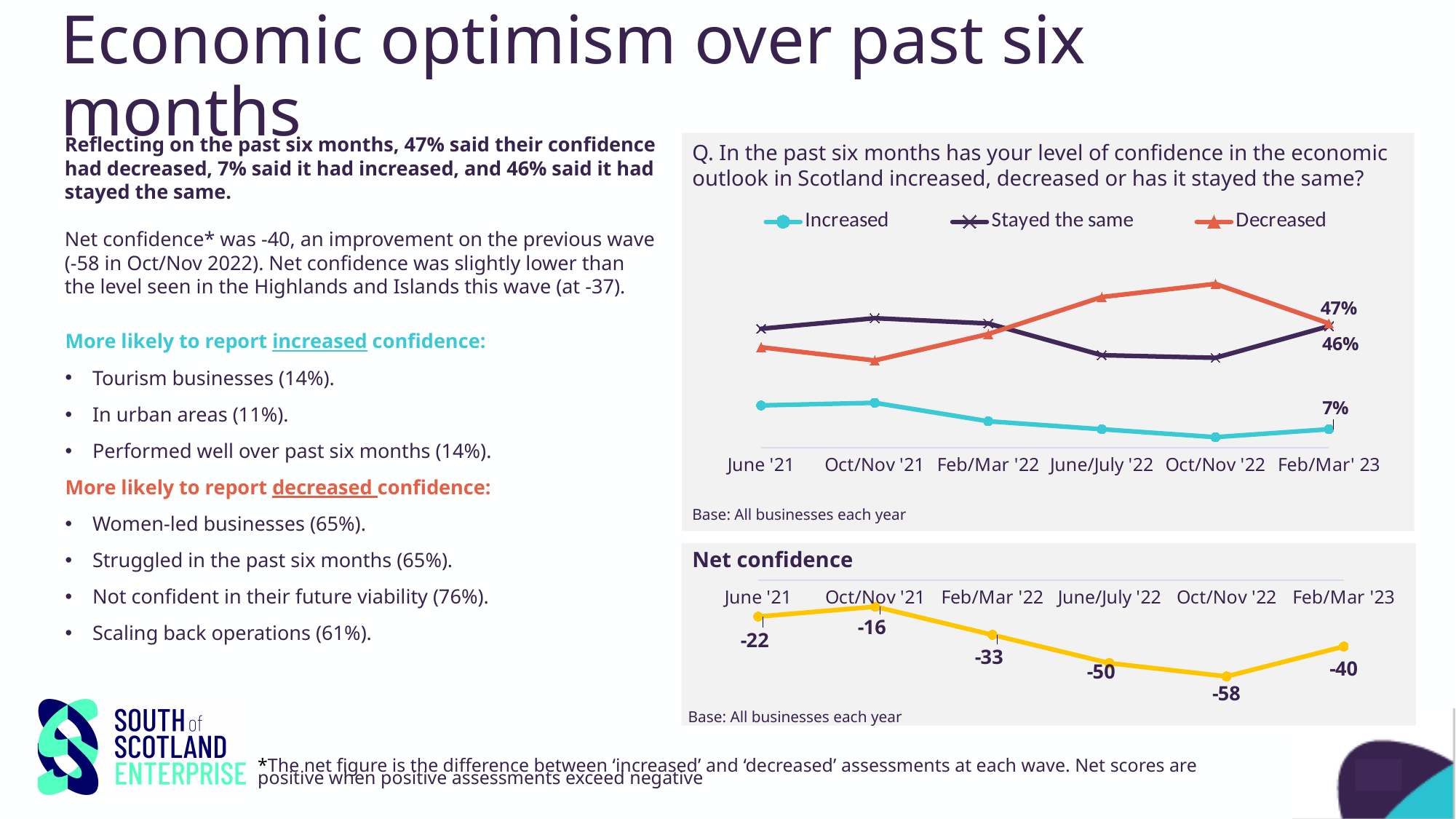
In the Net confidence chart, what is the value for Feb/Mar '23? -40 What kind of chart is the top chart? Line chart In the Net confidence chart, which wave has the highest net confidence? Oct/Nov '21 In the top chart, what is the value for Increased in Feb/Mar '23? 7% In the top chart, how many time points are shown on the x axis? 6 In the Net confidence chart, what is the difference between the Oct/Nov '22 and Feb/Mar '23 values? 18 In the Net confidence chart, does net confidence rise or fall from Oct/Nov '21 to Oct/Nov '22? Fall In the top chart, which series has the highest value in Oct/Nov '22? Decreased In the top chart, how many series does the legend list? 3 In the top chart, which series has the lowest value in Feb/Mar '23? Increased In the top chart, what is the value for Decreased in Feb/Mar '23? 47% In the Net confidence chart, what is the value for Oct/Nov '22? -58